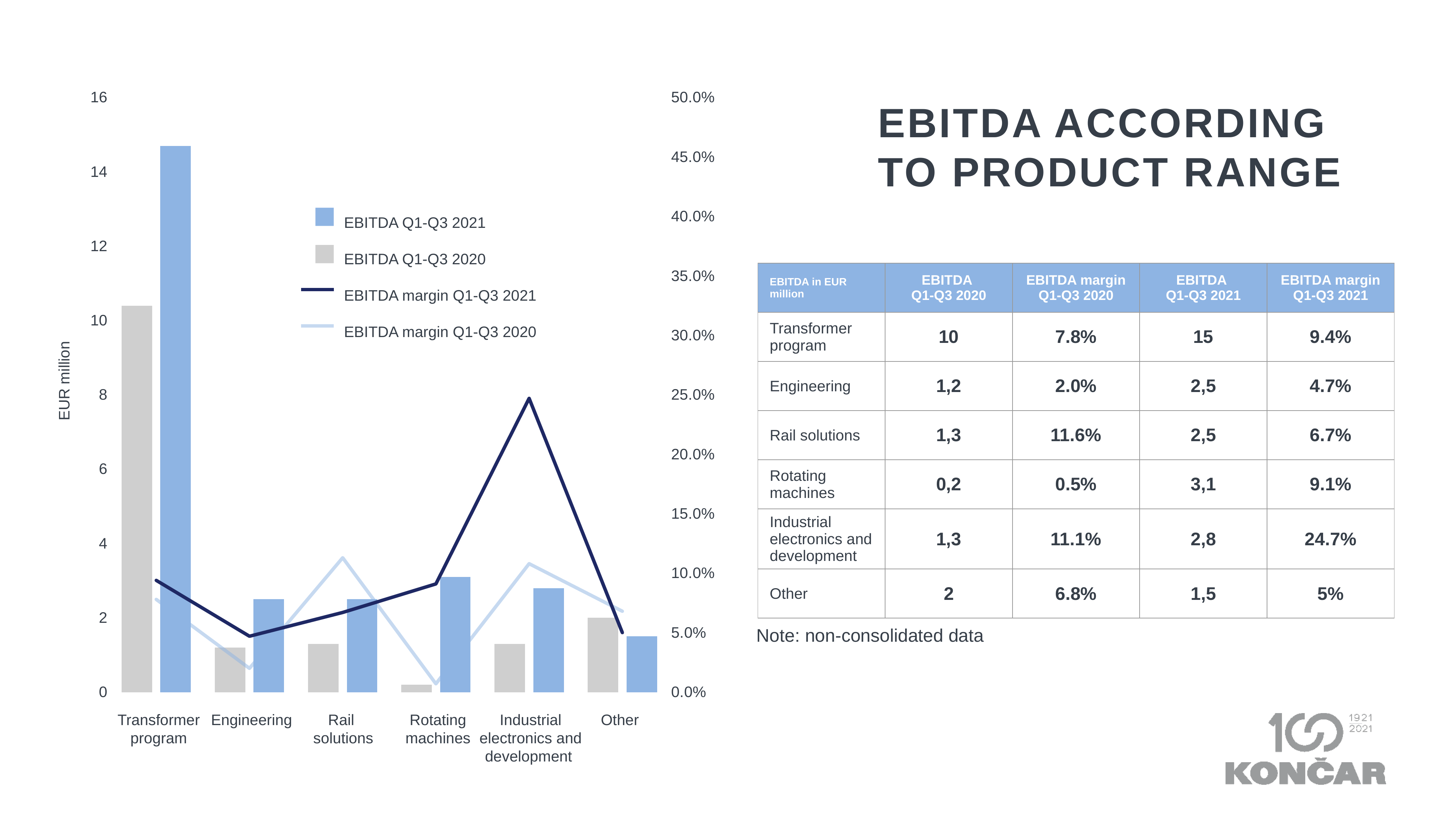
Is the EBITDA Q1-Q3 2020 bar for Transformer program greater or less than 8? greater Is the EBITDA margin Q1-Q3 2021 for Industrial electronics and development greater or less than 20.0%? greater What kind of chart is shown on the slide? A combined bar and line chart Which category has the highest EBITDA Q1-Q3 2021 bar? Transformer program For Rotating machines, which bar is taller: EBITDA Q1-Q3 2020 or EBITDA Q1-Q3 2021? EBITDA Q1-Q3 2021 Which category has the lowest EBITDA Q1-Q3 2020 bar? Rotating machines Is the EBITDA Q1-Q3 2021 bar for Transformer program greater or less than 12? greater For the Other category, which bar is taller: EBITDA Q1-Q3 2020 or EBITDA Q1-Q3 2021? EBITDA Q1-Q3 2020 How many series does the chart legend list? 4 At which category does the EBITDA margin Q1-Q3 2021 line reach its highest point? Industrial electronics and development What is the label on the left vertical axis of the chart? EUR million How many product range categories are shown on the x axis of the chart? 6